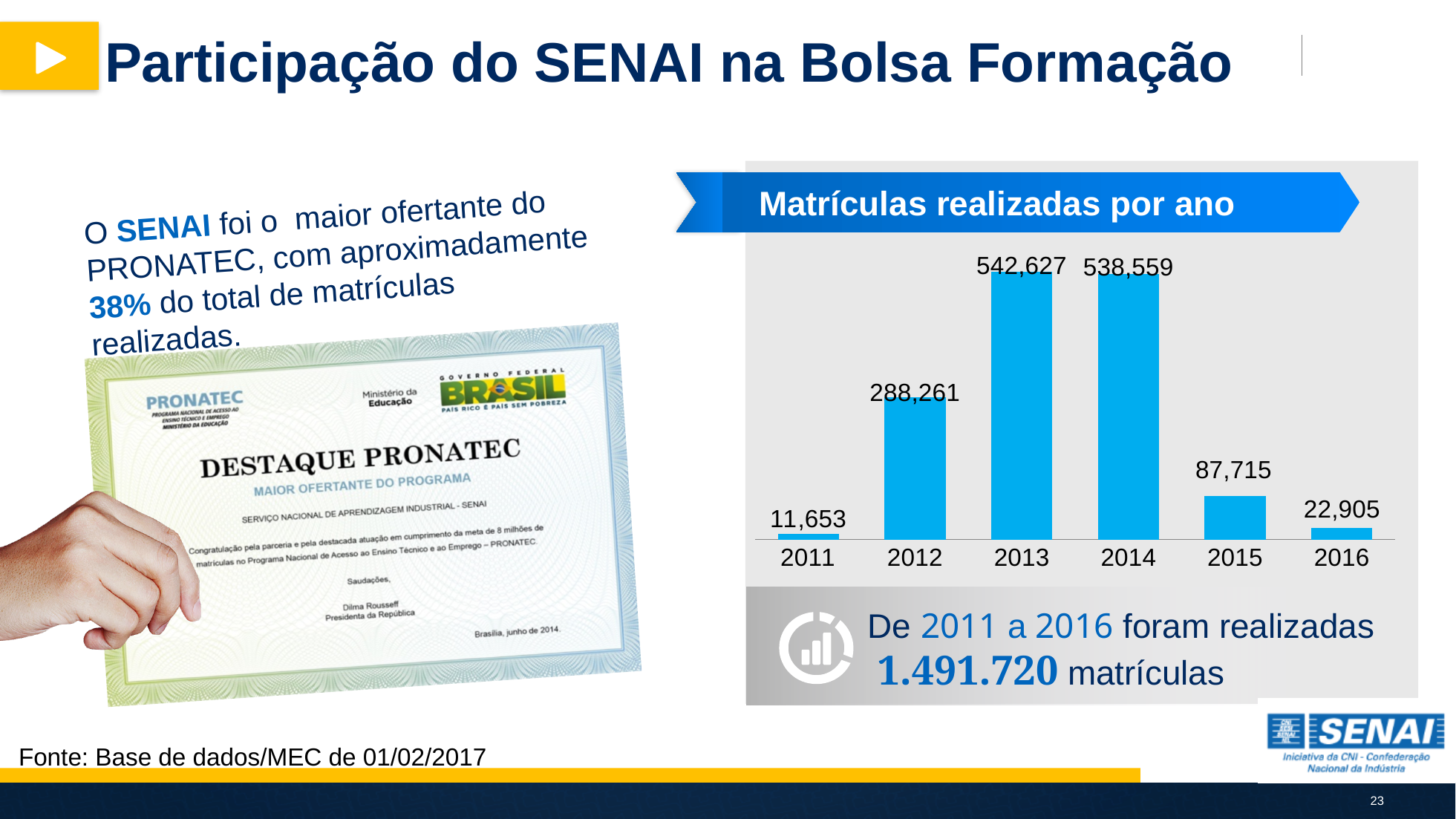
Do the values rise or fall from 2014 to 2016? fall What is the value for 2011 in the chart? 11,653 Which year has the lowest number of matrículas in the chart? 2011 What is the title of the chart on the right side of the slide? Matrículas realizadas por ano What is the value for 2015 in the chart? 87,715 How many years are shown on the x axis of the chart? 6 What is the value for 2013 in the chart? 542,627 What kind of chart is shown under the heading 'Matrículas realizadas por ano'? bar chart Which year has the highest number of matrículas in the chart? 2013 What is the difference between the values for 2013 and 2014? 4,068 Which year has a larger value, 2012 or 2016? 2012 What is the difference between the values for 2012 and 2015? 200,546